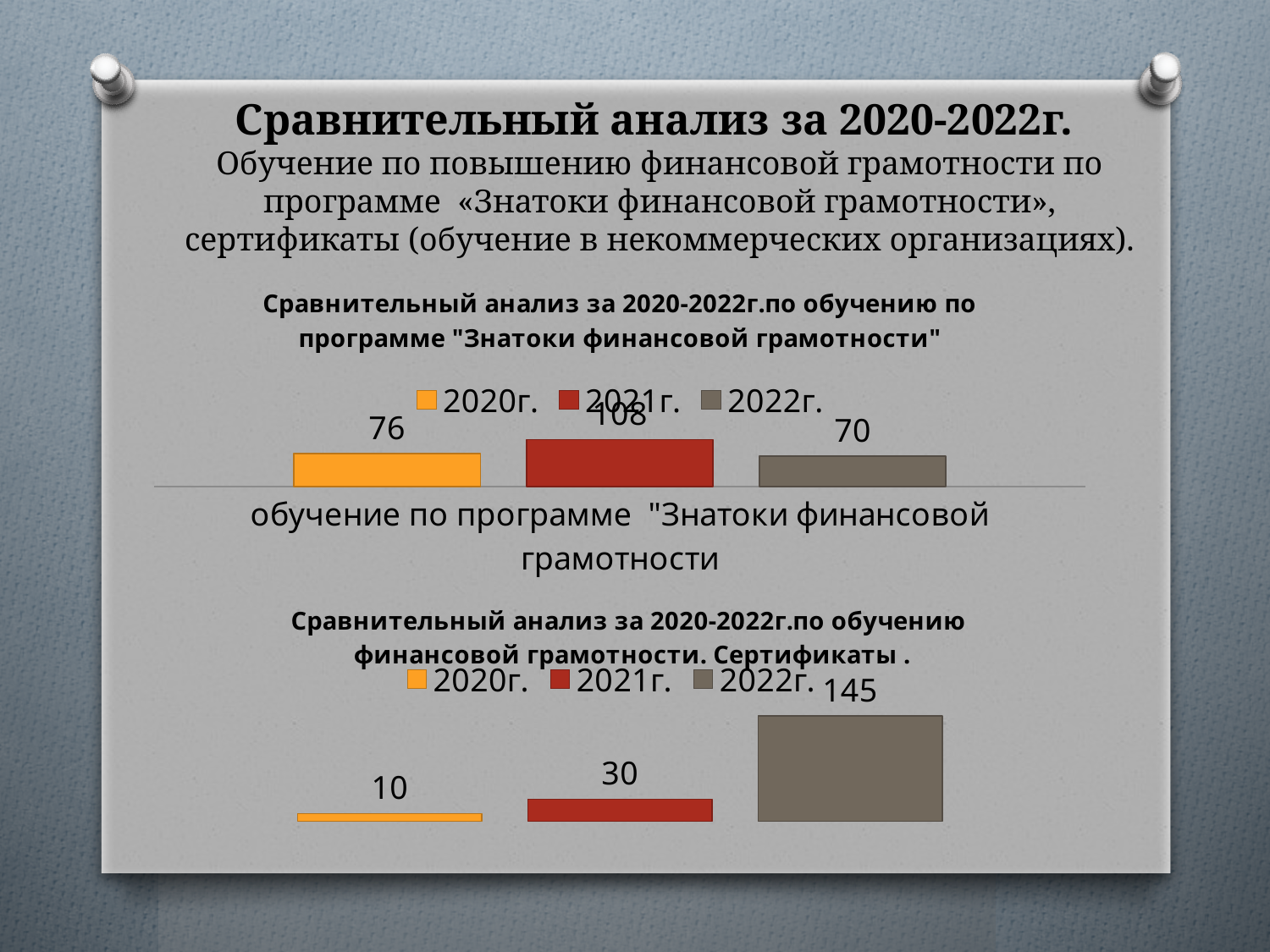
In the bottom chart, what is the value for 2022г.? 145 In the bottom chart, which year has the lowest value? 2020г. In the top chart, what is the value for 2021г.? 108 How many series does the legend of the bottom chart list? 3 In the bottom chart, what is the value for 2020г.? 10 In the bottom chart, what is the difference between the values for 2022г. and 2021г.? 115 In the top chart, which year has the lowest value? 2022г. In the top chart, what is the value for 2022г.? 70 In the bottom chart, which is larger, the value for 2021г. or the value for 2020г.? 2021г. What type of chart is the top chart? Bar chart In the top chart, what is the difference between the values for 2021г. and 2020г.? 32 In the top chart, which year has the highest value? 2021г.